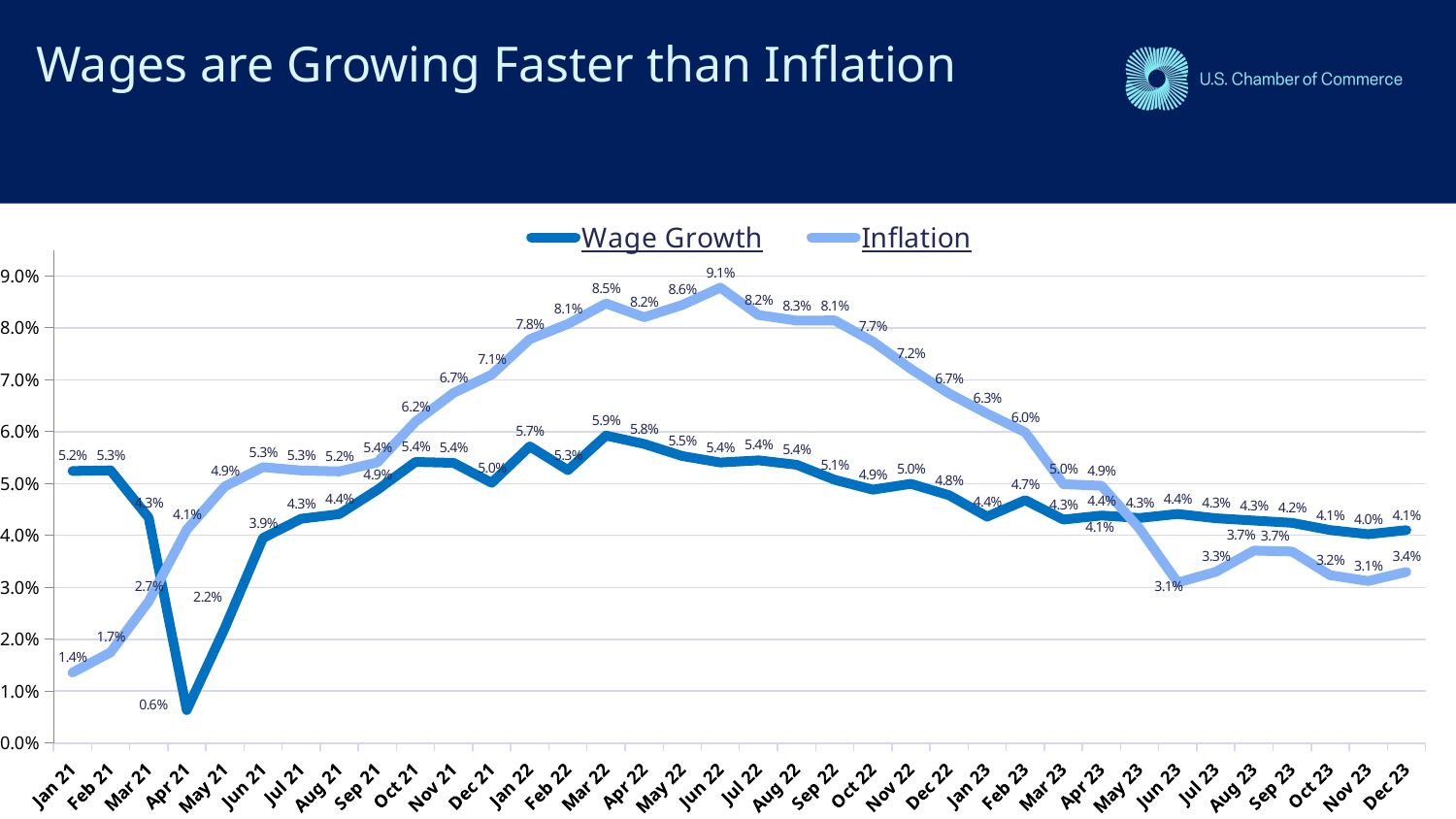
Does Inflation rise or fall from Jun 22 to Jun 23? Fall What kind of chart is shown on the slide? Line chart In Jan 21, which is larger: Wage Growth or Inflation? Wage Growth What is the title of the chart on the slide? Wages are Growing Faster than Inflation What is the Inflation value for Jun 22? 9.1% What is the Inflation value for Jun 23? 3.1% In which month is Wage Growth at its lowest value? Apr 21 How many series does the legend list? 2 How many months are plotted along the x axis? 36 What is the Wage Growth value for Mar 22? 5.9% What is the difference between Wage Growth and Inflation in Dec 23? 0.7 percentage points In which month does Inflation reach its highest value? Jun 22